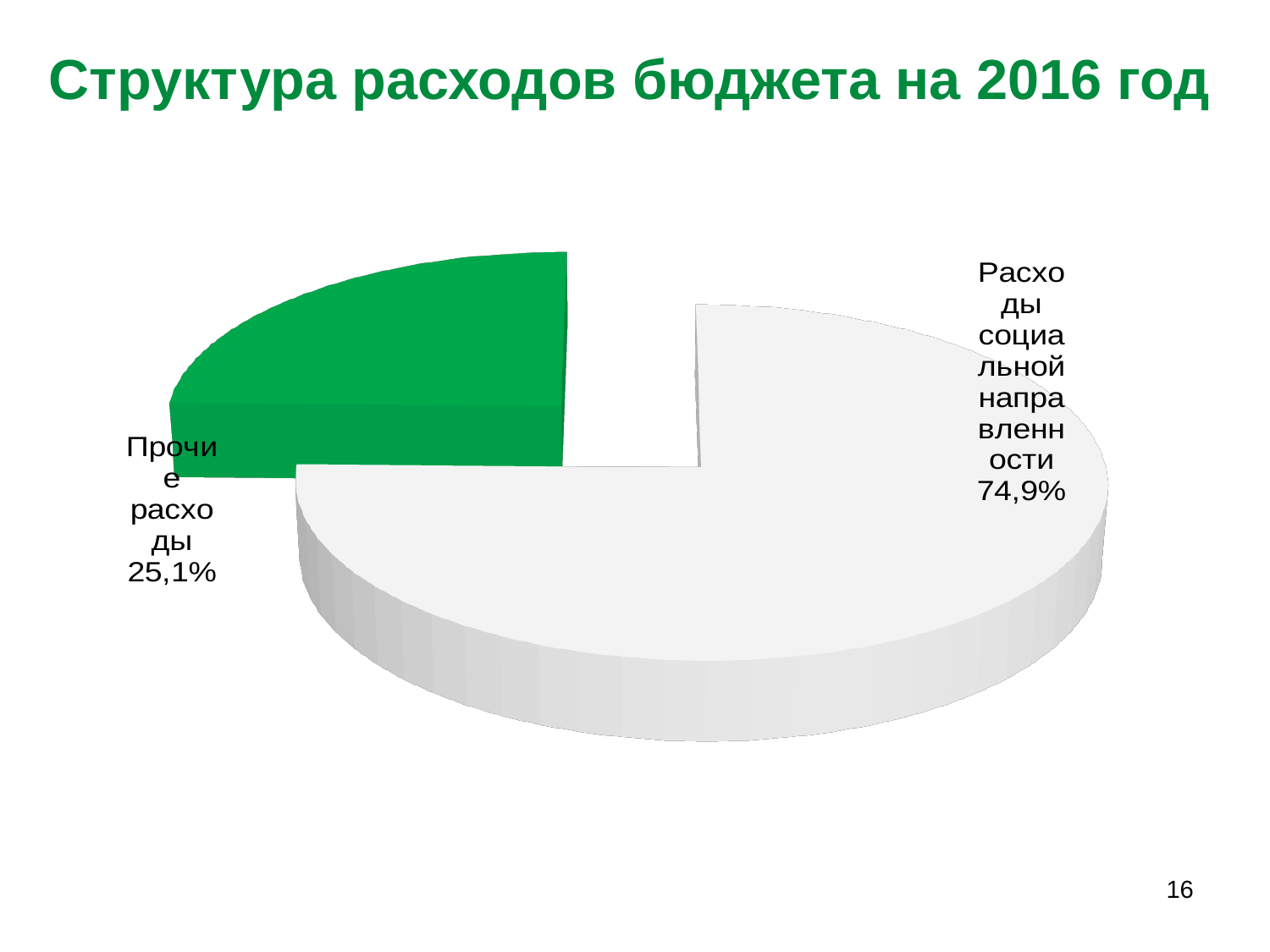
Which slice of the pie is the largest? Расходы социальной направленности What share of the pie is labelled "Расходы социальной направленности"? 74,9% What kind of chart is shown on the slide? Pie chart Is the share for "Прочие расходы" greater or less than 50%? less How many slices does the pie chart have? 2 What is the title of the slide? Структура расходов бюджета на 2016 год Which slice of the pie is the smallest? Прочие расходы What colour is the "Прочие расходы" slice? Green What is the difference in percentage points between "Расходы социальной направленности" and "Прочие расходы"? 49,8 Which is larger: "Прочие расходы" or "Расходы социальной направленности"? Расходы социальной направленности What share of the pie is labelled "Прочие расходы"? 25,1%